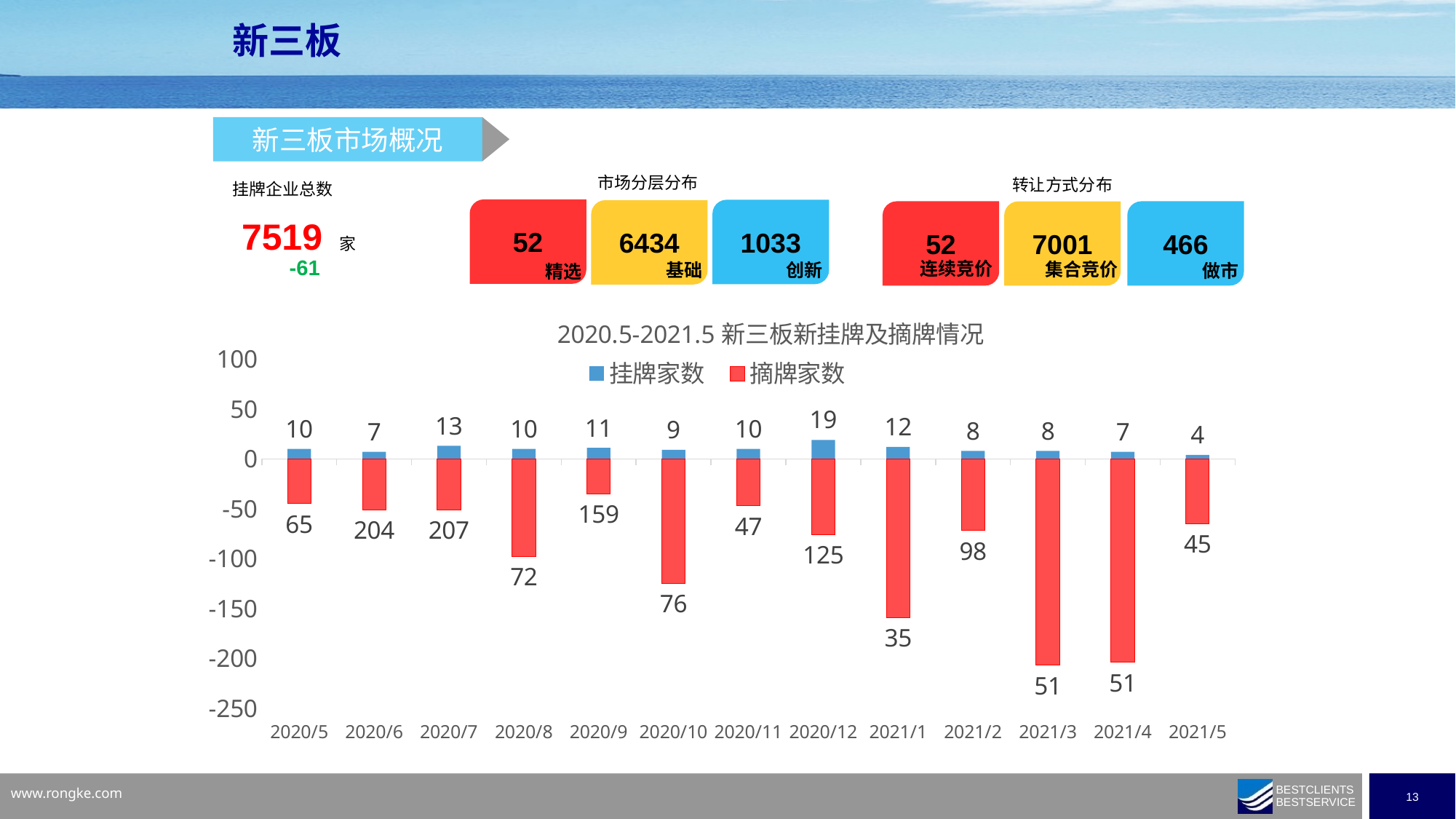
What is the 挂牌家数 value for 2020/12? 19 How many months are shown on the x axis of the chart? 13 What type of chart is shown at the bottom of the slide? bar chart What is the difference between the 挂牌家数 values for 2020/12 and 2020/6? 12 How many series does the chart legend list? 2 What is the title of the bar chart? 2020.5-2021.5 新三板新挂牌及摘牌情况 What is the 挂牌家数 value for 2021/5? 4 Which month has the highest 挂牌家数 value? 2020/12 Which is larger, the 挂牌家数 value for 2020/7 or for 2021/2? 2020/7 What is the 摘牌家数 label shown for 2021/1? 35 What is the 摘牌家数 label shown for 2020/7? 207 Which month has the lowest 挂牌家数 value? 2021/5